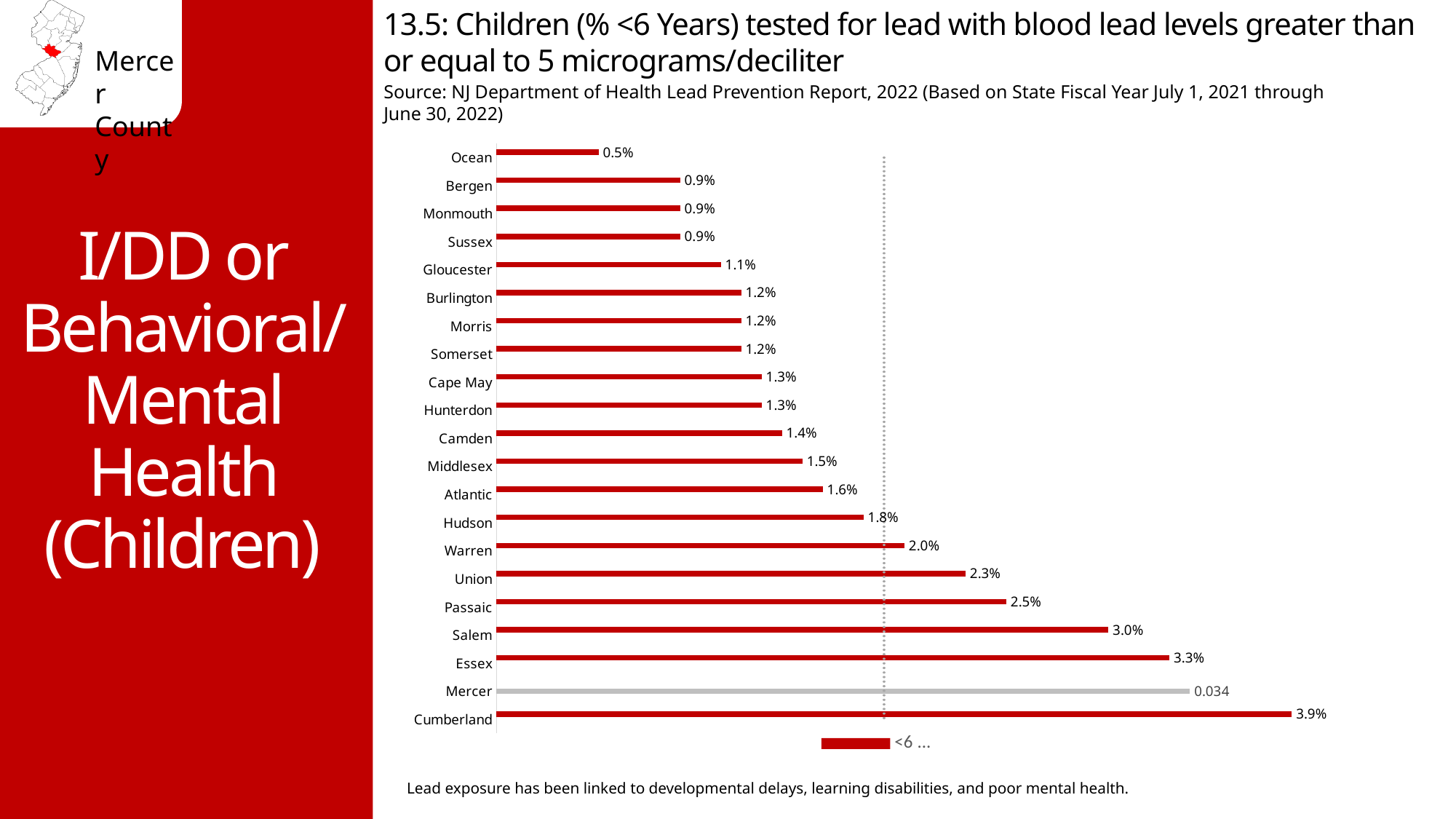
Which has a larger value, Union or Warren? Union What is the difference between the values for Cumberland and Essex? 0.6% What is the value for Ocean? 0.5% How many counties are shown in the chart? 21 Which county has the highest value? Cumberland What value is labeled for Mercer? 0.034 Which county has the lowest value? Ocean What is the value for Hudson? 1.8% What is the value for Cumberland? 3.9% What is the value for Passaic? 2.5% What type of chart is shown on the slide? bar chart What is the difference between the values for Salem and Ocean? 2.5%